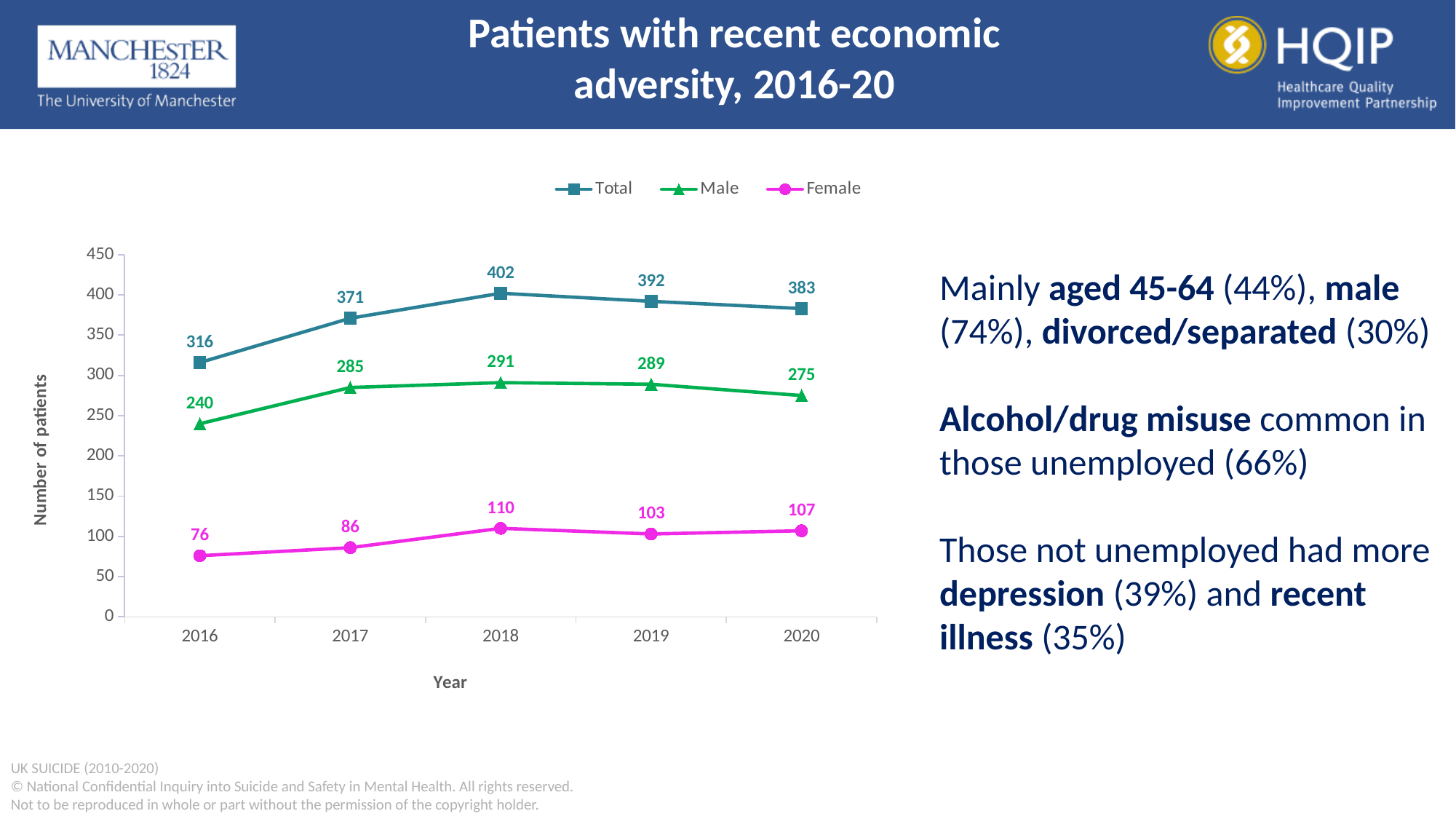
How many series does the legend list? 3 How many years are plotted on the x axis? 5 What is the Male value in 2020? 275 Which is larger: the Total value in 2017 or the Total value in 2020? 2020 What kind of chart is shown on the slide? line chart What is the Total number of patients with recent economic adversity in 2018? 402 In which year is the Female series lowest? 2016 Is the Male value in 2016 greater or less than 250? less What is the label of the y axis? Number of patients What is the Female value in 2016? 76 What is the difference between the Male and Female values in 2019? 186 In which year is the Total series highest? 2018